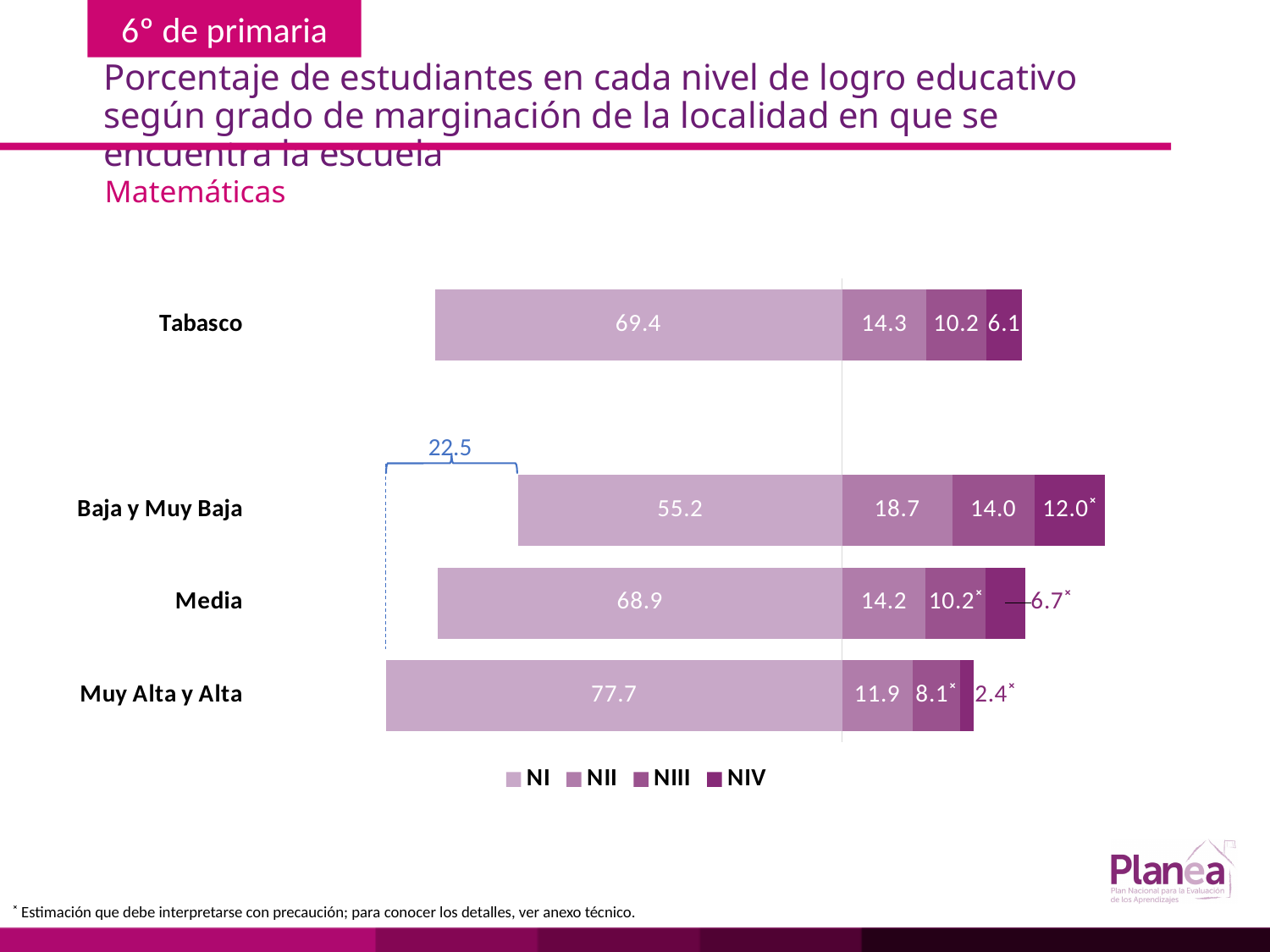
How many series does the legend list? 4 What is the NI value for Tabasco? 69.4 What is the difference between the NI value for Muy Alta y Alta and the NI value for Baja y Muy Baja? 22.5 What is the NII value for Baja y Muy Baja? 18.7 How many categories (bars) are shown in the chart? 4 Which category has the highest NI value? Muy Alta y Alta Which series is shown in the lightest shade of purple in the legend? NI What is the NIII value for Muy Alta y Alta? 8.1 What is the NIV value for Media? 6.7 What kind of chart is shown on the slide? Stacked bar chart Which is larger, the NII value for Tabasco or the NII value for Media? Tabasco Which category has the lowest NIV value? Muy Alta y Alta